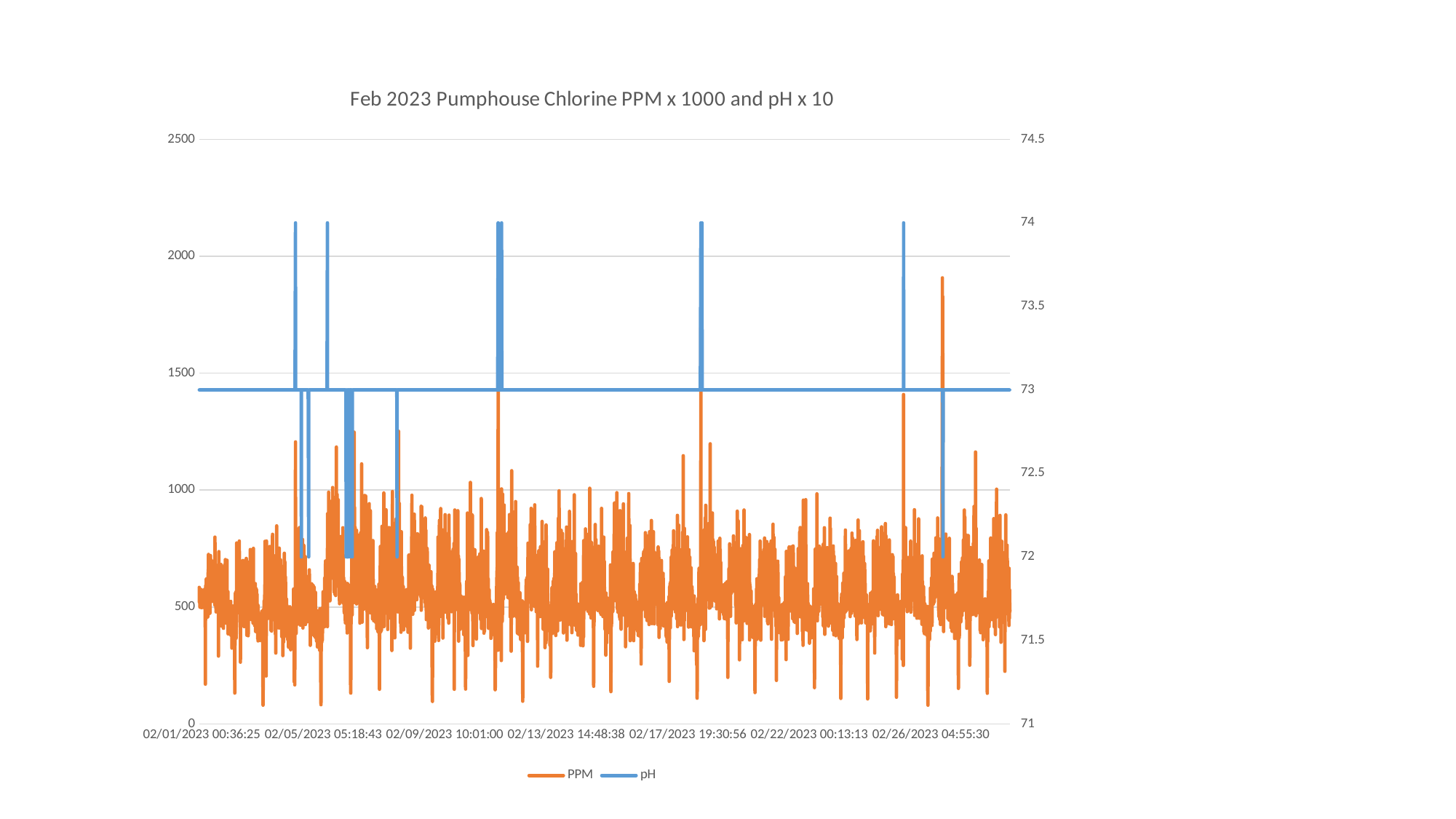
What is the lowest value shown on the right vertical axis? 71 Which series is drawn in orange? PPM What kind of chart is shown on the slide? Line chart Is the highest PPM spike greater or less than 2000? less What is the first date label shown on the x axis? 02/01/2023 00:36:25 How many series does the legend list? 2 Is the highest PPM spike greater or less than 1500? greater What is the title of the chart? Feb 2023 Pumphouse Chlorine PPM x 1000 and pH x 10 At what level on the right axis does the pH line sit for most of the month? 73 What is the highest value shown on the left vertical axis? 2500 What is the highest value shown on the right vertical axis? 74.5 What is the peak value on the right axis reached by the pH spikes? 74